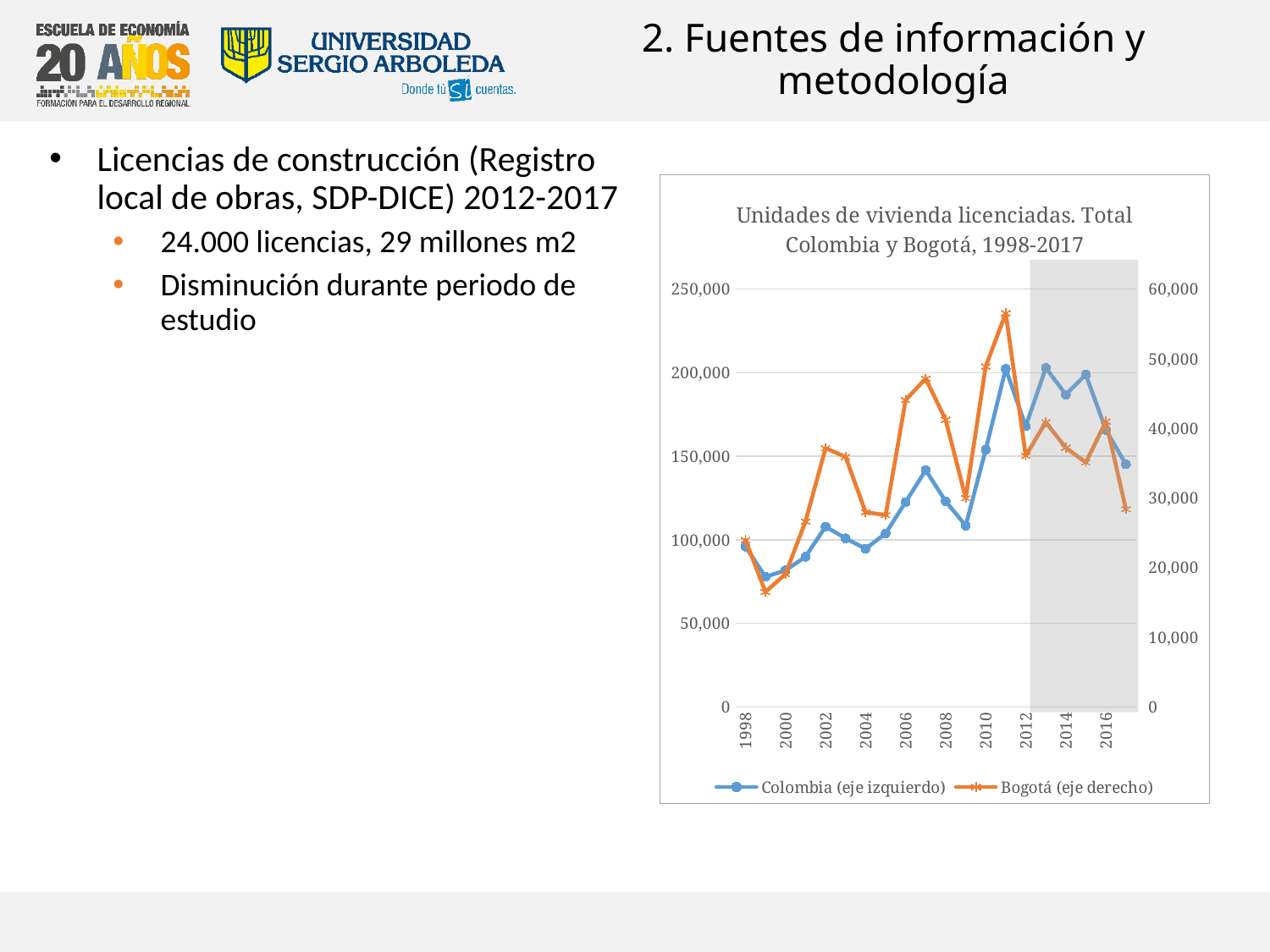
Is the value for Colombia (eje izquierdo) in 1999 greater or less than 100,000? less Is the value for Bogotá (eje derecho) in 2011 greater or less than 50,000? greater Does the Colombia (eje izquierdo) series rise or fall between 2013 and 2017? fall What are the two series named in the chart legend? Colombia (eje izquierdo) and Bogotá (eje derecho) What is the title of the chart? Unidades de vivienda licenciadas. Total Colombia y Bogotá, 1998-2017 Which is larger for the Colombia (eje izquierdo) series: the value in 2011 or the value in 2017? 2011 How many years (data points per series) are plotted on the chart? 20 What kind of chart is shown on the slide? line chart How many series does the chart legend list? 2 In which year does the Bogotá (eje derecho) series reach its lowest value? 1999 In which year does the Colombia (eje izquierdo) series reach its lowest value? 1999 In which year does the Bogotá (eje derecho) series reach its highest value? 2011